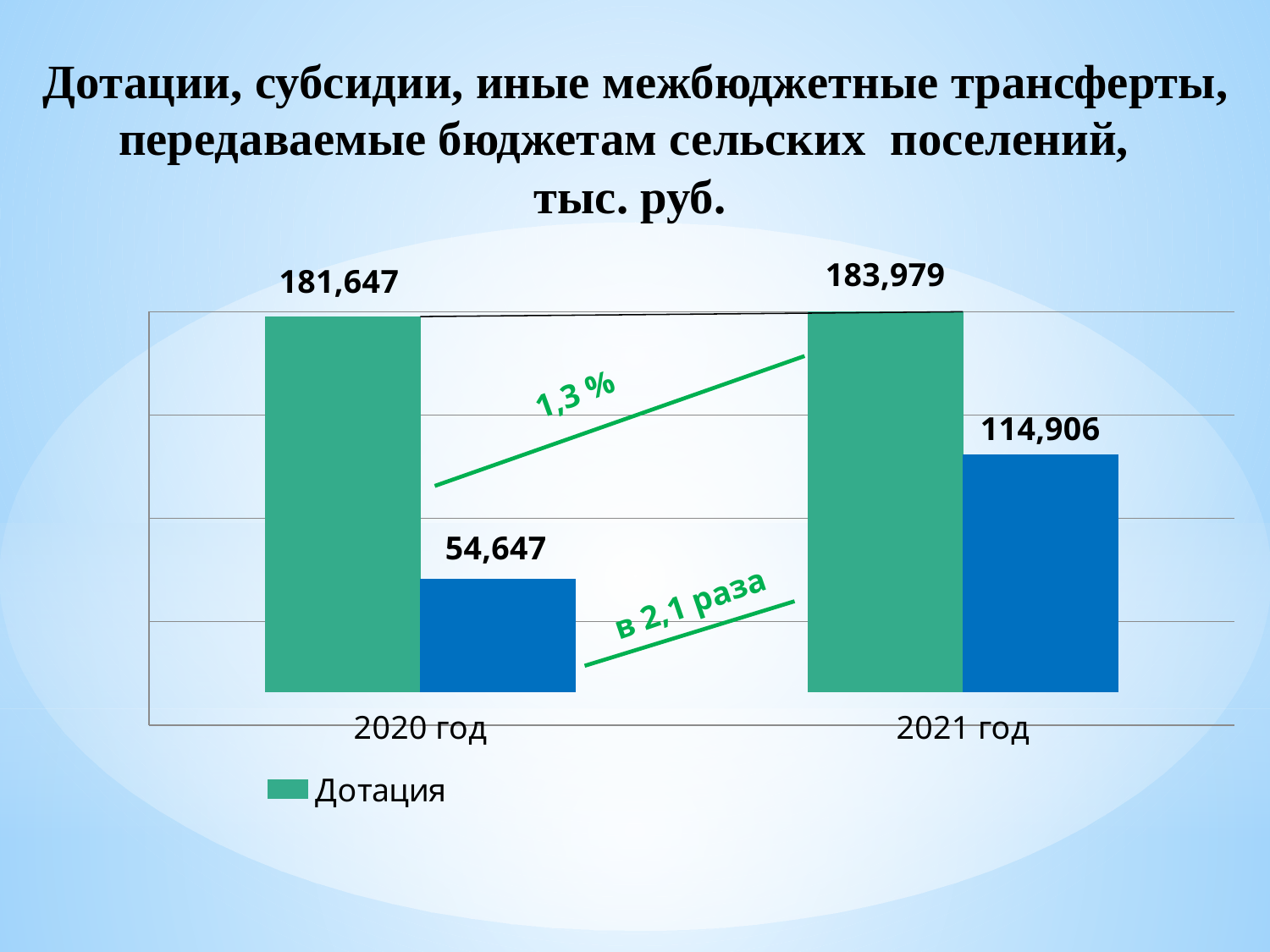
By how much does Дотация in 2021 год exceed Дотация in 2020 год? 2,332 In which year is the Дотация value higher? 2021 год What is the value of Дотация for 2021 год? 183,979 What is the value of the blue bar for 2021 год? 114,906 For 2020 год, which is larger: the Дотация bar or the blue bar? Дотация How many series does the legend list? 1 How many year categories are shown on the x axis? 2 What is the difference between the blue bar values for 2021 год and 2020 год? 60,259 What is the value of Дотация for 2020 год? 181,647 What kind of chart is shown on the slide? bar chart Do the blue bar values rise or fall from 2020 год to 2021 год? rise What is the value of the blue bar for 2020 год? 54,647